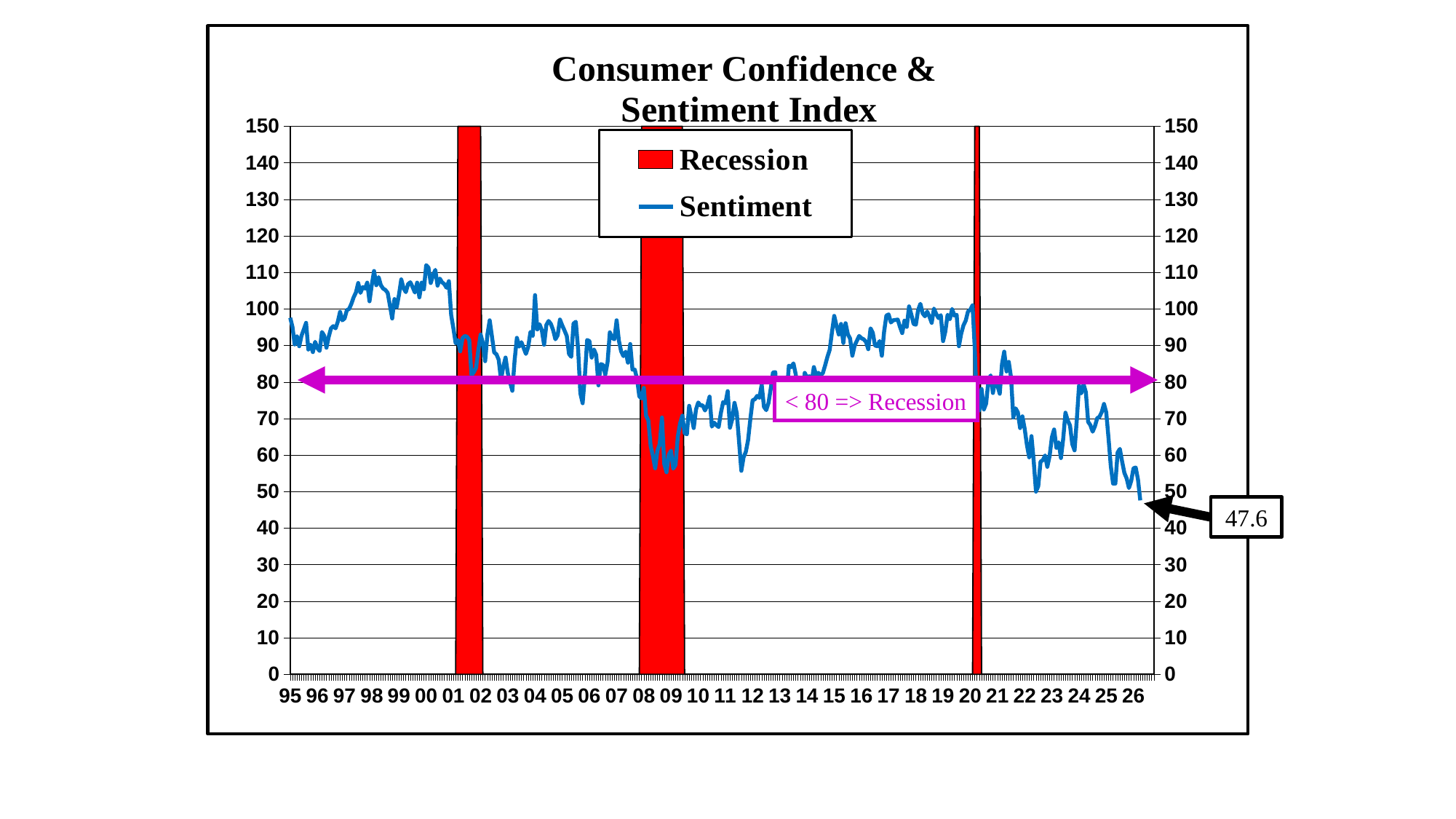
How many red Recession bands are shaded on the chart? 3 Is the Sentiment value in 2019 greater or less than 90? greater What is the title of the chart? Consumer Confidence & Sentiment Index How many series does the legend list? 2 Is the Sentiment value at its 2009 low greater or less than 60? less What is the most recent Sentiment value labelled at the end of the line? 47.6 Is the Sentiment value at its 2022 low greater or less than 60? less What kind of chart is shown on the slide? line chart What is the highest value shown on the vertical axis? 150 Does the Sentiment line generally rise or fall from 2021 to 2026? fall